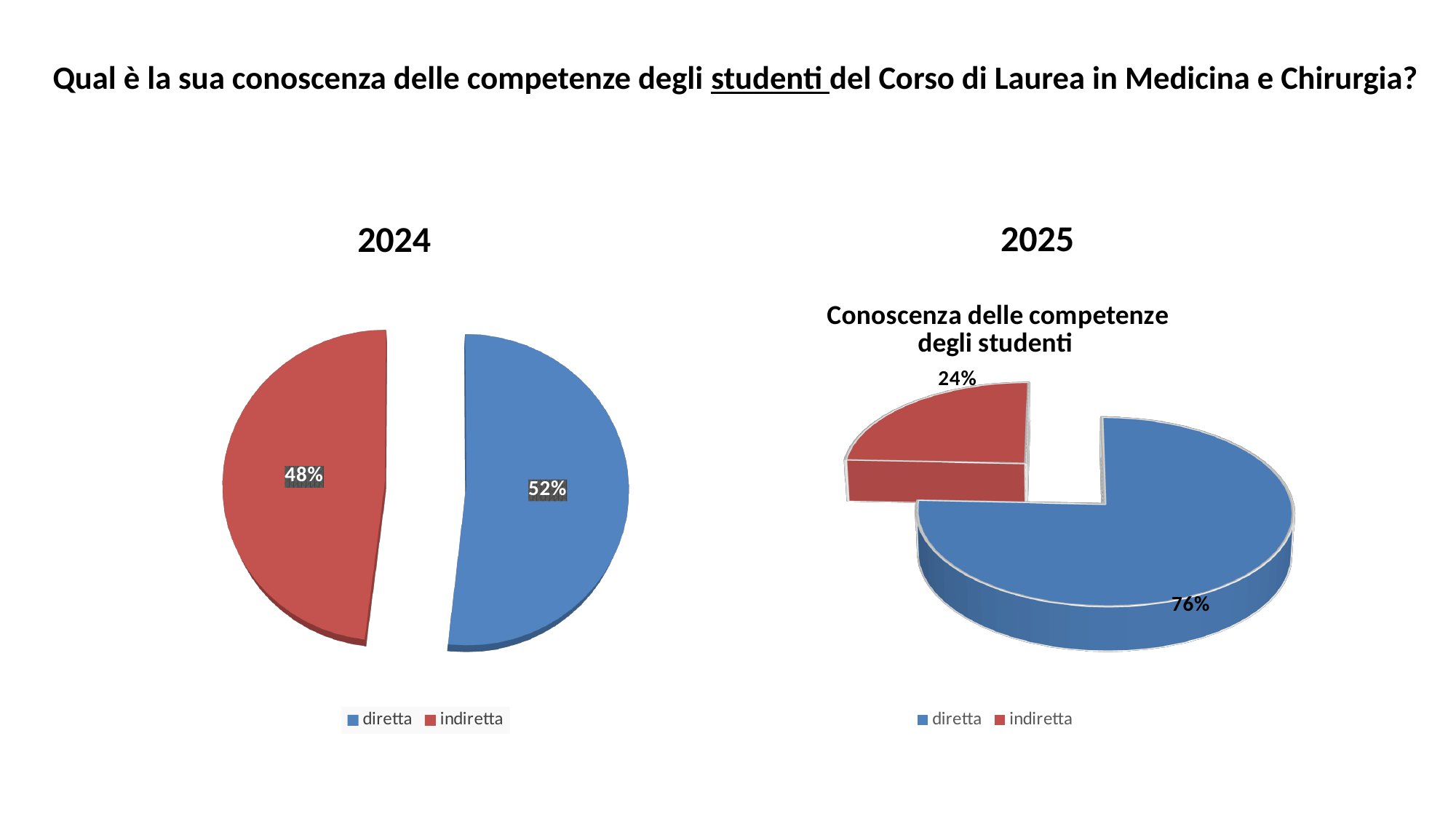
In the 2025 pie chart, what is the difference between the 'diretta' and 'indiretta' shares? 52% In the 2025 pie chart, which slice is the largest? diretta Comparing the 'diretta' share in the 2024 chart with the 'diretta' share in the 2025 chart, which is larger? 2025 What is the title printed above the 2025 pie chart? Conoscenza delle competenze degli studenti In the 2024 pie chart, what share is labelled for 'indiretta'? 48% How many slices does the 2025 pie chart have? 2 In the 2024 pie chart, what is the difference between the 'diretta' and 'indiretta' shares? 4% In the 2025 pie chart, what share is labelled for 'indiretta'? 24% In the 2025 pie chart, what share is labelled for 'diretta'? 76% What kind of chart is used for the 2024 data? Pie chart In the 2025 pie chart, which slice is the smallest? indiretta